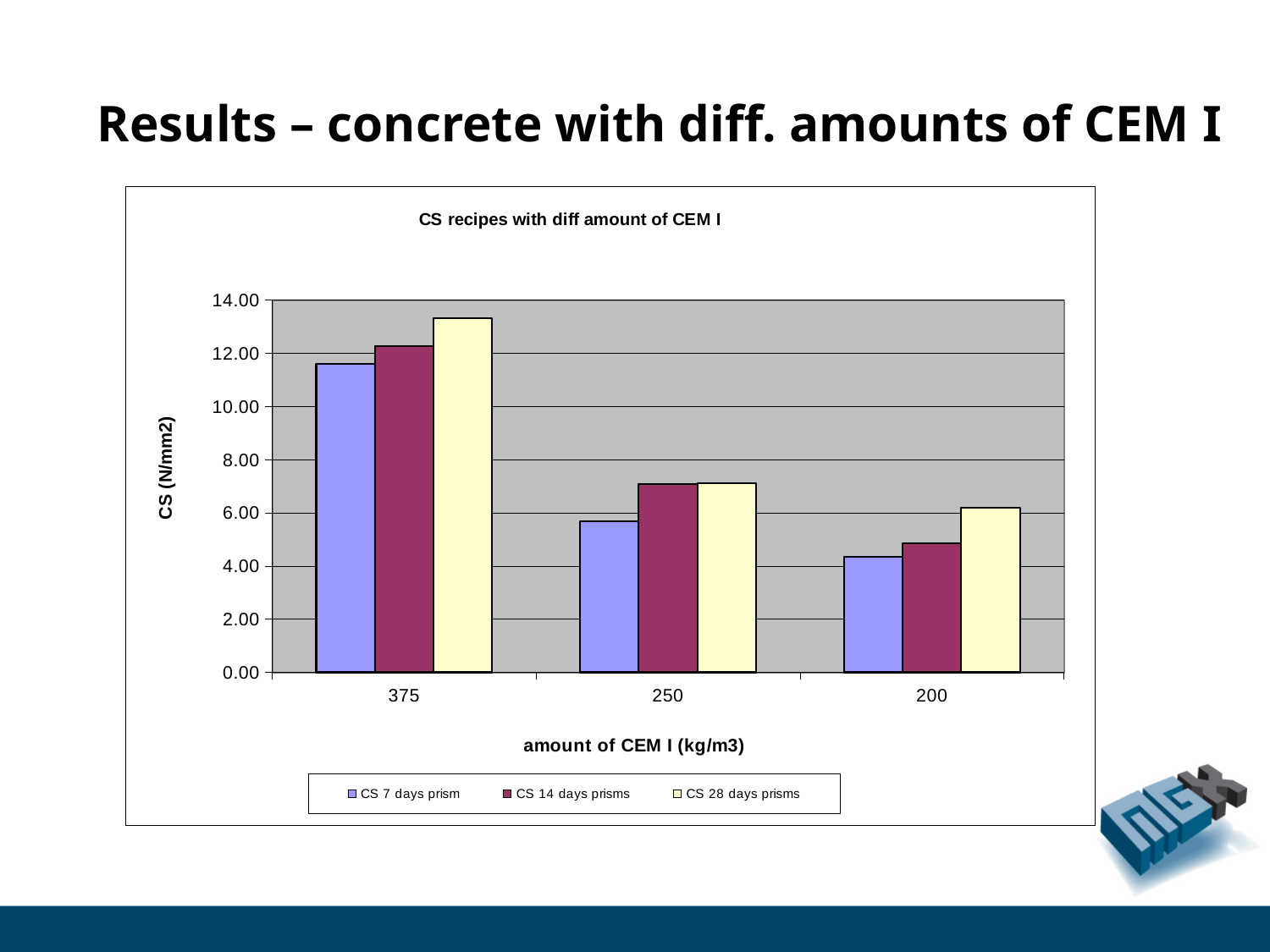
Which amount of CEM I has the lowest CS 7 days prism value? 200 Is the CS 28 days prisms value for 200 kg/m3 greater or less than 6.00? greater Which is larger: the CS 7 days prism value for 375 kg/m3 or for 250 kg/m3? 375 Is the CS 28 days prisms value for 375 kg/m3 greater or less than 12.00? greater Do the CS 28 days prisms values rise or fall moving from 375 to 200 along the x axis? fall How many series does the legend list? 3 Which amount of CEM I has the highest CS 28 days prisms value? 375 What is the label of the y axis? CS (N/mm2) How many categories of CEM I amount are shown on the x axis? 3 What is the title of the chart? CS recipes with diff amount of CEM I What kind of chart is shown on the slide? bar chart Is the CS 7 days prism value for 250 kg/m3 greater or less than 6.00? less